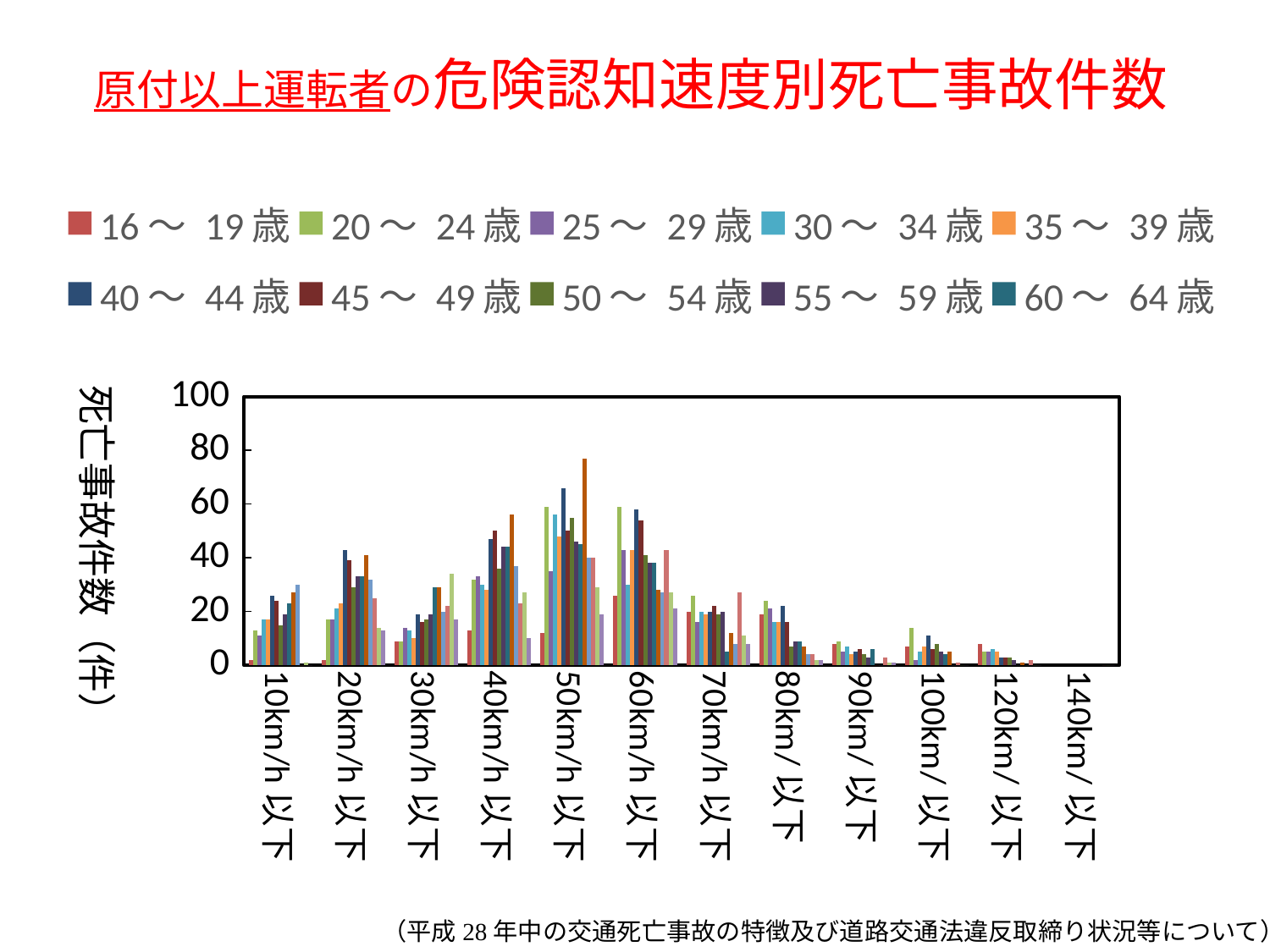
How many speed categories are shown along the x axis? 12 How many age-group series does the legend list? 10 Which speed category contains the tallest bar in the chart? 50km/h以下 Is the value for 45～49歳 at 50km/h以下 greater or less than 60? less What is the label of the y axis? 死亡事故件数（件） Do the bars generally rise or fall moving from 60km/h以下 to 140km/h以下 along the x axis? fall Is the value for 20～24歳 at 60km/h以下 greater or less than 40? greater Are the values for 140km/h以下 greater or less than 20 for every age group? less What kind of chart is shown on the slide? bar chart What is the first age group listed in the legend? 16～19歳